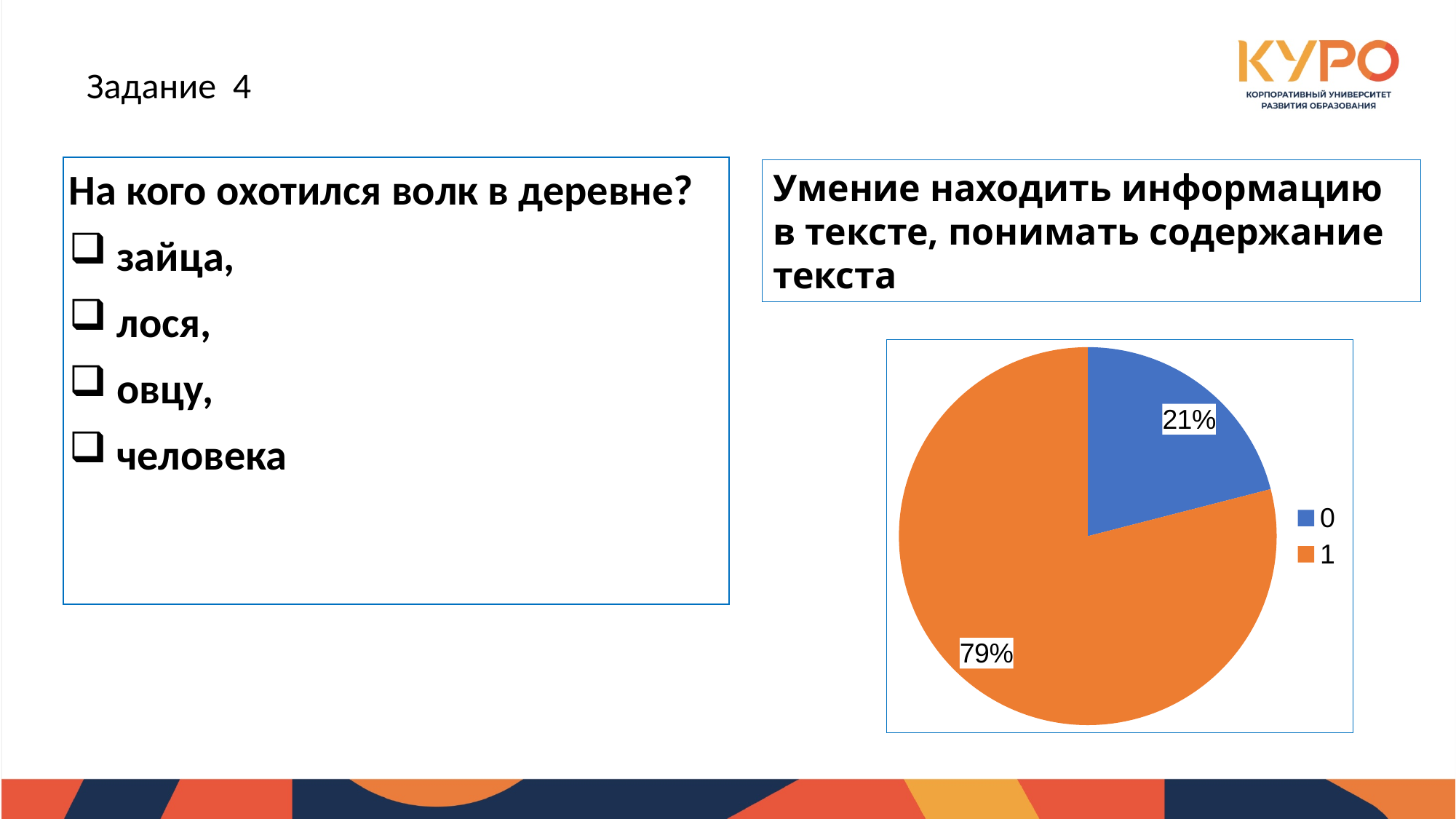
What share of the pie does category 1 take? 79% Is the share for category 1 greater or less than 50%? greater What colour is the slice for category 0? blue What kind of chart is shown on the slide? pie chart Which category has the largest slice of the pie? 1 What share of the pie does category 0 take? 21% Which slice is larger, category 0 or category 1? 1 What is the difference in percentage points between the slices for category 1 and category 0? 58 percentage points Which category has the smallest slice of the pie? 0 How many slices does the pie chart have? 2 What colour is the slice for category 1? orange How many entries does the legend list? 2